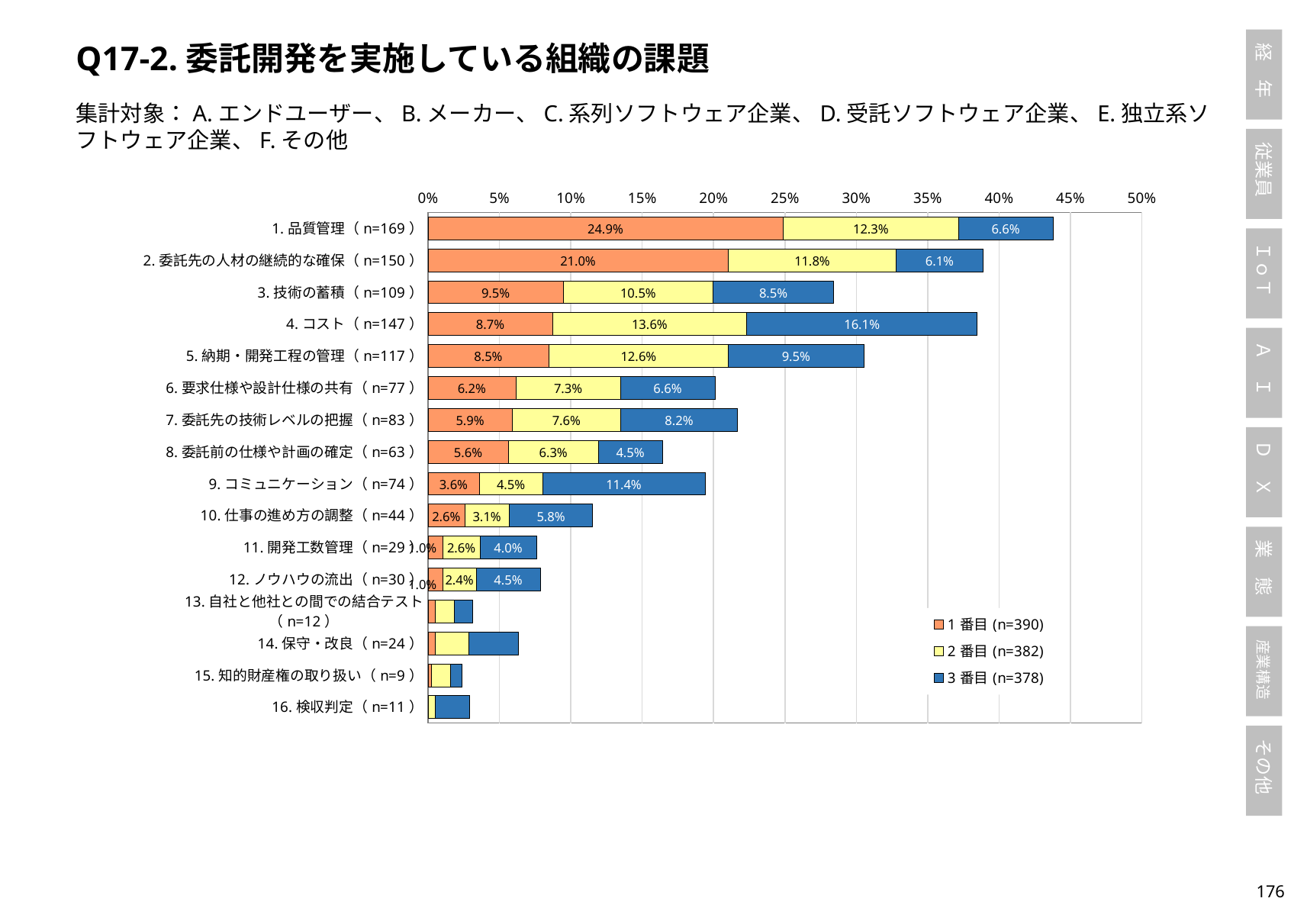
What kind of chart is shown on the slide? Stacked bar chart What is the difference between the 1番目 values for 1. 品質管理 and 2. 委託先の人材の継続的な確保? 3.9% How many categories are plotted on the chart? 16 How many series does the legend list? 3 What is the total of the stacked bar for 1. 品質管理? 43.8% Is the total length of the stacked bar for 3. 技術の蓄積 greater or less than 25%? greater Which category has the highest 1番目 value? 1. 品質管理 Which is larger, the 3番目 value for 9. コミュニケーション or the 3番目 value for 5. 納期・開発工程の管理? 9. コミュニケーション What is the 1番目 value for 1. 品質管理? 24.9% What is the 3番目 value for 4. コスト? 16.1% What is the 2番目 value for 5. 納期・開発工程の管理? 12.6% Which category has the highest 3番目 value? 4. コスト